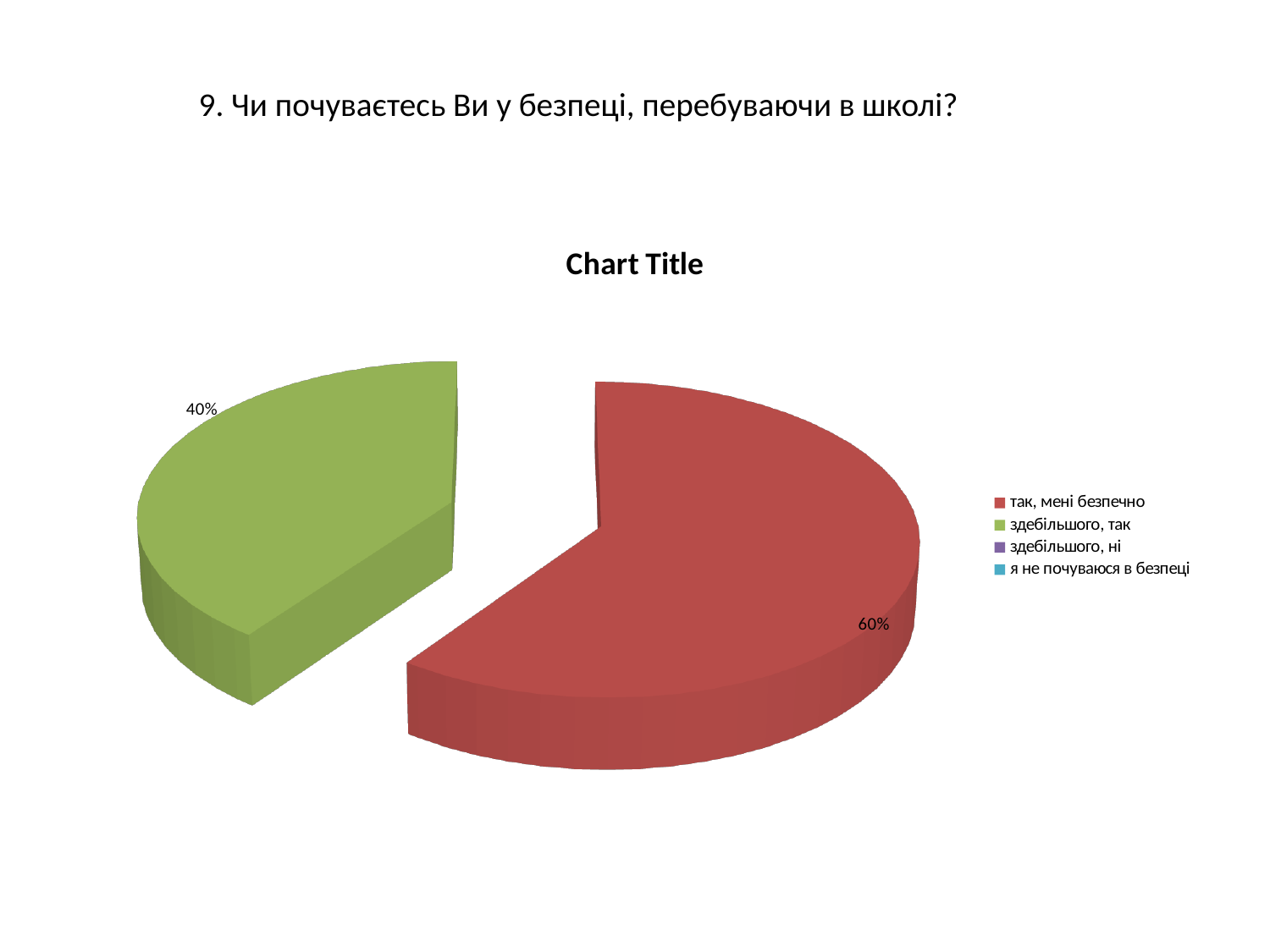
What colour is the slice for "здебільшого, так"? Green What share of the pie does the slice for "так, мені безпечно" represent? 60% Which category has the largest slice of the pie? так, мені безпечно How many slices are visible in the pie? 2 What share of the pie does the slice for "здебільшого, так" represent? 40% What is the difference in percentage points between the "так, мені безпечно" slice and the "здебільшого, так" slice? 20 percentage points How many entries does the legend list? 4 Which of the two visible slices is larger: "так, мені безпечно" or "здебільшого, так"? так, мені безпечно What is the title shown above the pie chart? Chart Title What kind of chart is shown on the slide? Pie chart